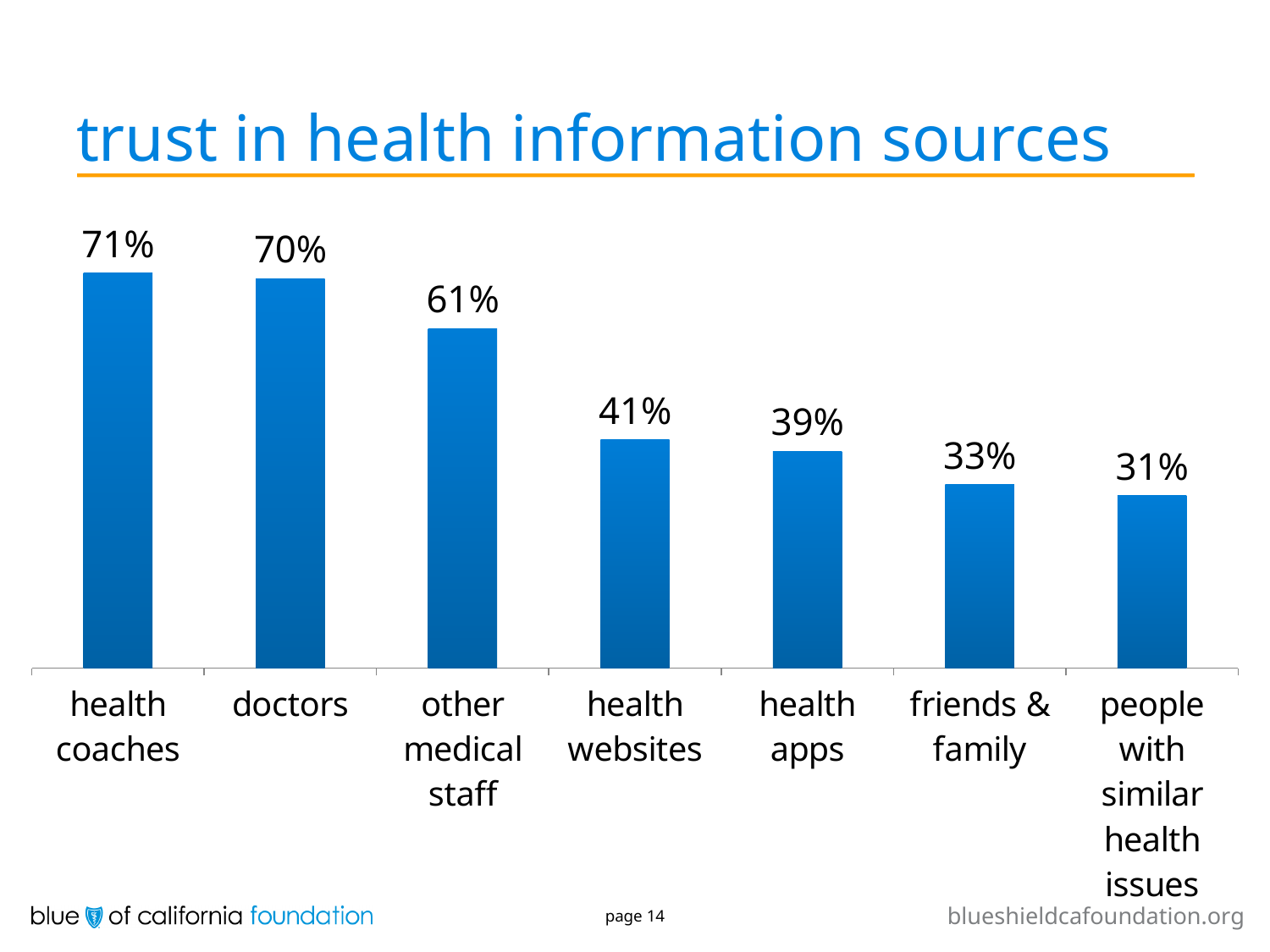
Which is larger, the value for health websites or the value for friends & family? health websites What kind of chart is shown on the slide? bar chart Do the values rise or fall from left to right along the x axis? fall Which category has the highest value? health coaches What is the value for health websites? 41% What is the difference between the values for doctors and health apps? 31% What is the value for people with similar health issues? 31% Which category has the lowest value? people with similar health issues What is the difference between the values for other medical staff and friends & family? 28% What is the value for health coaches? 71% How many categories are shown in the chart? 7 What is the title of the chart? trust in health information sources